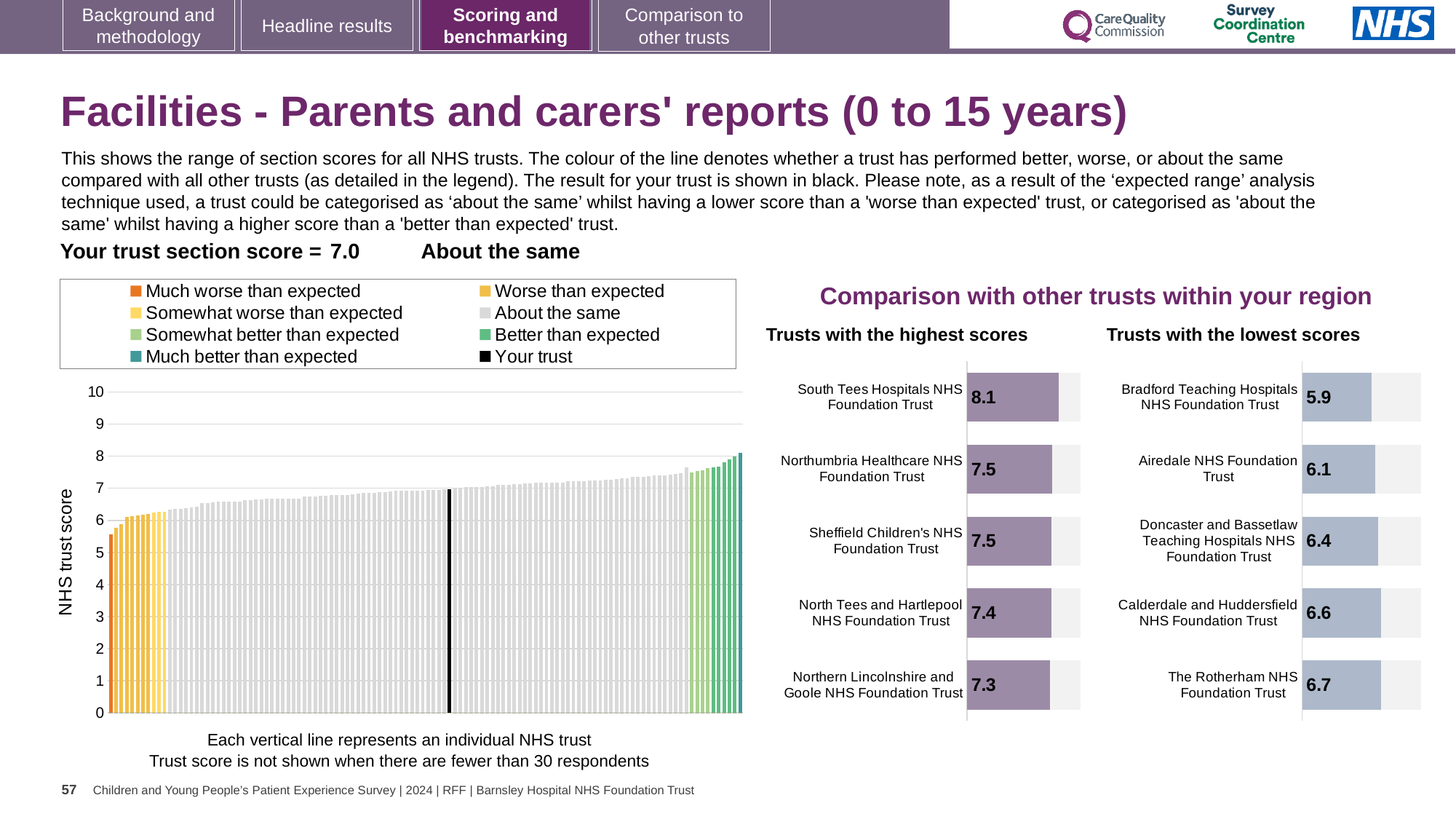
In the 'Trusts with the highest scores' chart, what is the score for South Tees Hospitals NHS Foundation Trust? 8.1 In the 'Trusts with the highest scores' chart, which trust has the highest score? South Tees Hospitals NHS Foundation Trust In the 'Trusts with the highest scores' chart, what is the difference between the scores of South Tees Hospitals NHS Foundation Trust and Northern Lincolnshire and Goole NHS Foundation Trust? 0.8 In the 'Trusts with the lowest scores' chart, which has the larger score: Airedale NHS Foundation Trust or Doncaster and Bassetlaw Teaching Hospitals NHS Foundation Trust? Doncaster and Bassetlaw Teaching Hospitals NHS Foundation Trust What is the y-axis label of the large chart on the left? NHS trust score In the large chart on the left, is the value of the leftmost (lowest) bar greater or less than 6? less What kind of chart is the large chart on the left showing all NHS trusts? Bar chart In the 'Trusts with the lowest scores' chart, what is the score for Bradford Teaching Hospitals NHS Foundation Trust? 5.9 What is the section score for your trust shown on the slide? 7.0 In the 'Trusts with the lowest scores' chart, which trust has the lowest score? Bradford Teaching Hospitals NHS Foundation Trust How many entries does the legend above the large chart on the left list? 8 How many trusts are shown in the 'Trusts with the highest scores' chart? 5